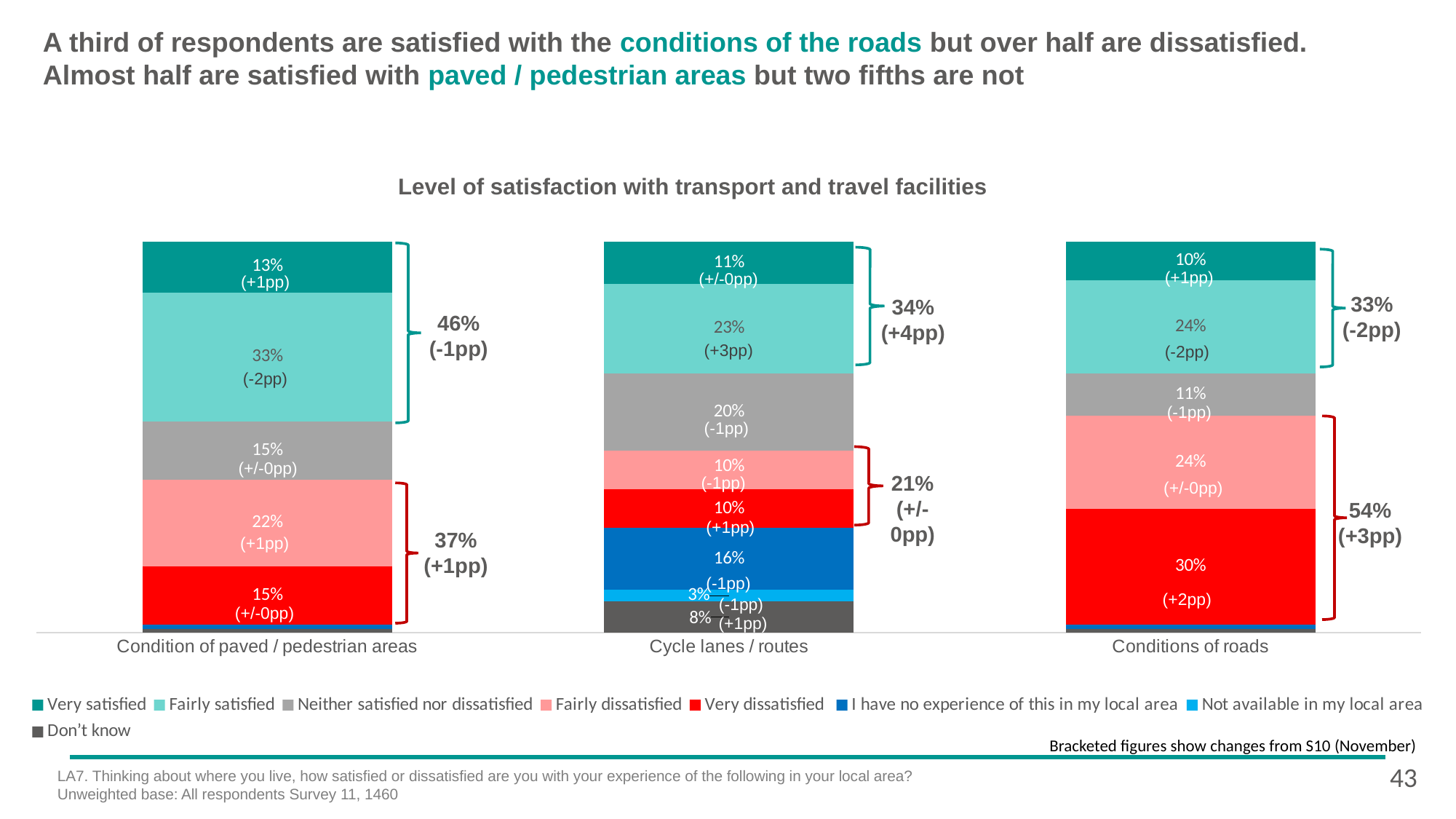
How many categories are shown on the x axis of the chart? 3 What percentage of respondents said they have no experience of cycle lanes / routes in their local area? 16% What percentage of respondents are very dissatisfied with the conditions of roads? 30% How many series does the legend list? 8 Which has a larger fairly satisfied percentage: condition of paved / pedestrian areas or conditions of roads? Condition of paved / pedestrian areas What is the combined percentage of very satisfied and fairly satisfied respondents for cycle lanes / routes? 34% Which category has the highest percentage of very dissatisfied respondents? Conditions of roads What type of chart is shown on the slide? Stacked bar chart What is the difference between the very satisfied percentage for condition of paved / pedestrian areas and for conditions of roads? 3% What is the bracketed change shown for fairly satisfied with cycle lanes / routes? +3pp What percentage of respondents are fairly satisfied with the condition of paved / pedestrian areas? 33% What percentage of respondents are neither satisfied nor dissatisfied with cycle lanes / routes? 20%